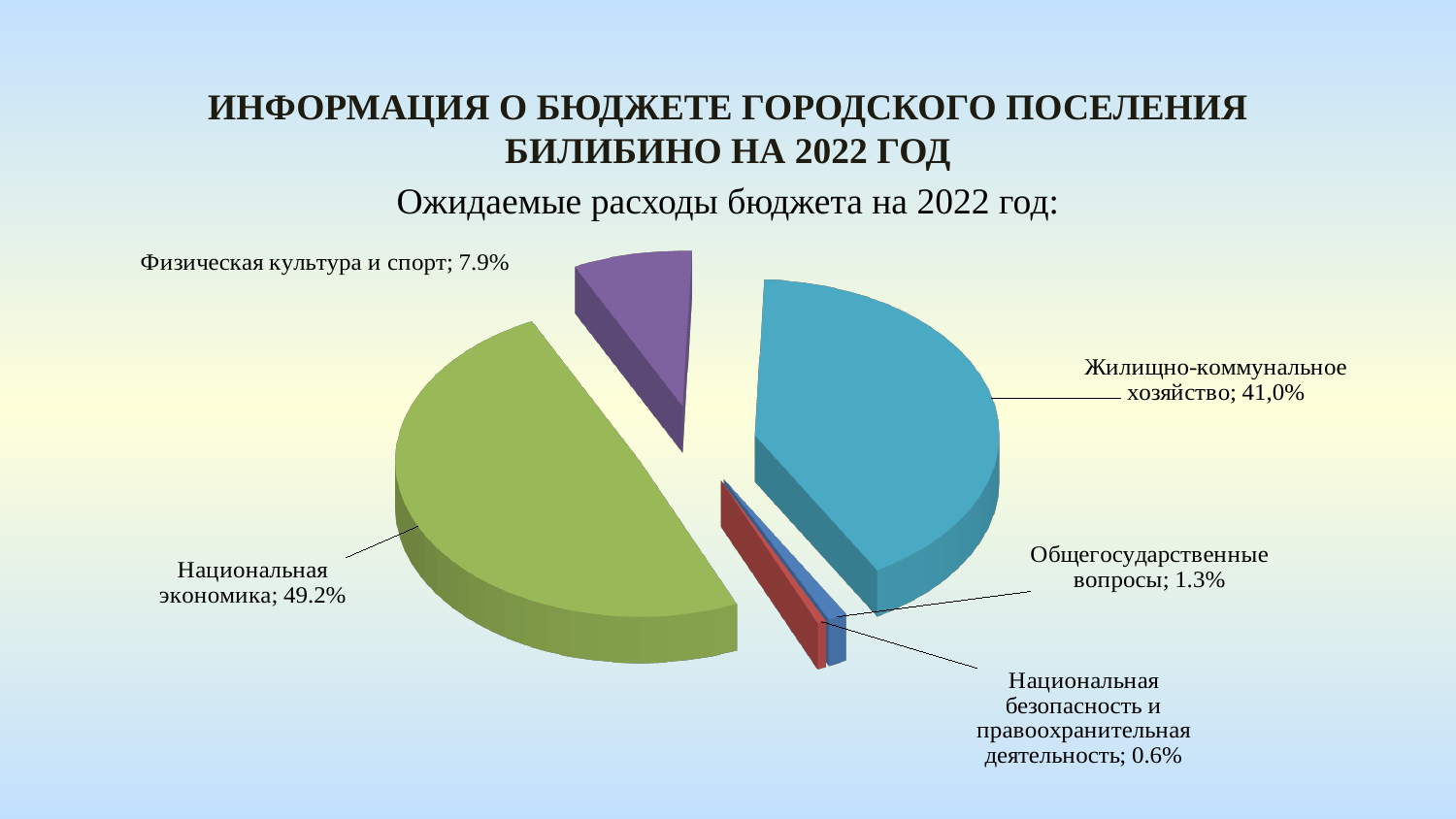
What share is shown for Общегосударственные вопросы? 1.3% How many categories are shown in the pie chart? 5 What share is shown for Жилищно-коммунальное хозяйство? 41,0% Which category has the largest share of the pie? Национальная экономика What is the difference in percentage points between Национальная экономика and Жилищно-коммунальное хозяйство? 8.2 What share is shown for Физическая культура и спорт? 7.9% What share of the expected 2022 budget expenses goes to Национальная экономика? 49.2% Which is larger: the share for Физическая культура и спорт or the share for Общегосударственные вопросы? Физическая культура и спорт What kind of chart is shown on the slide? Pie chart Which category has the smallest share of the pie? Национальная безопасность и правоохранительная деятельность What is the subtitle of the chart on the slide? Ожидаемые расходы бюджета на 2022 год: What share is shown for Национальная безопасность и правоохранительная деятельность? 0.6%